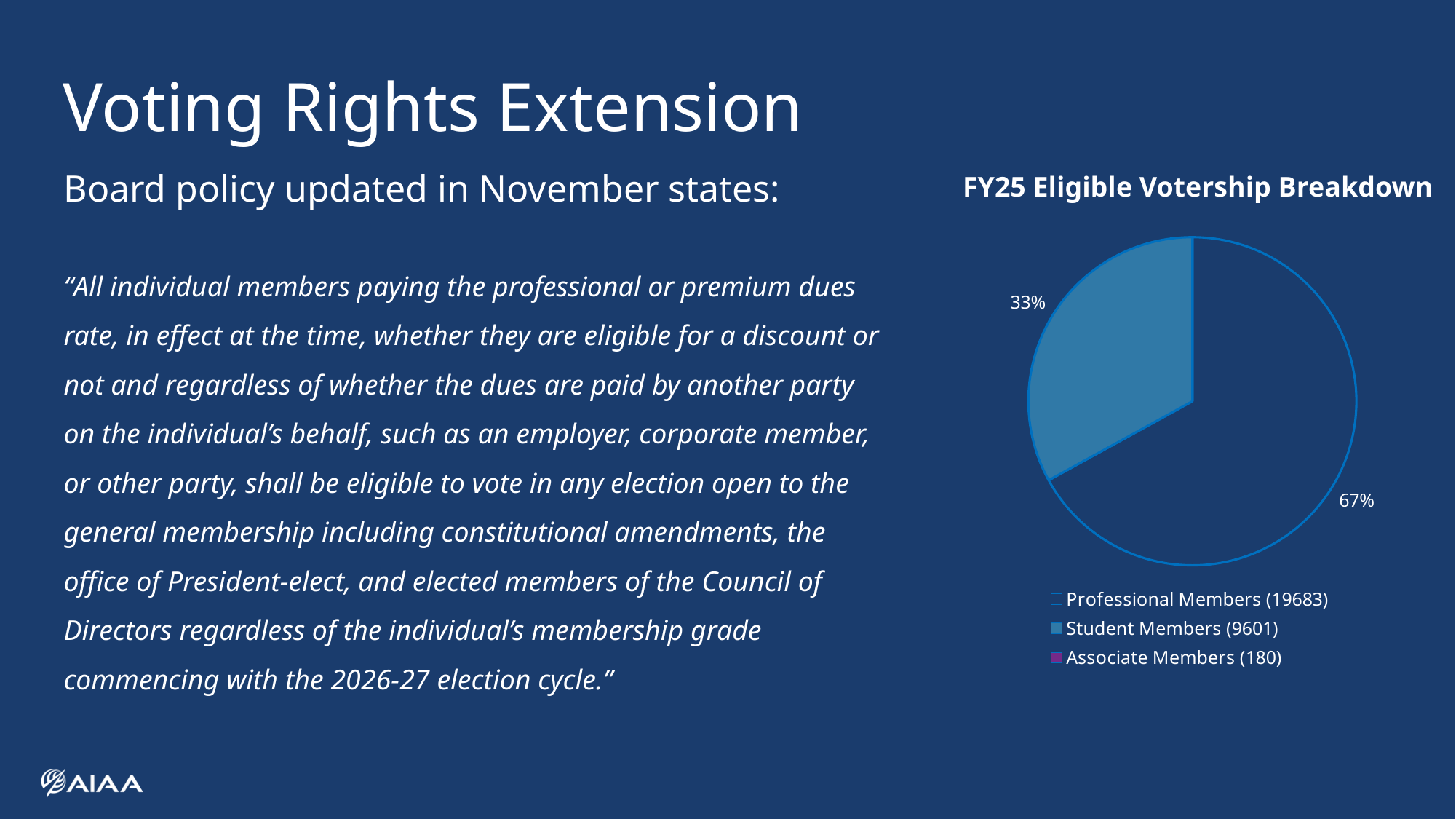
According to the legend, how many Professional Members are there? 19683 What share of the pie do Student Members represent? 33% According to the legend, how many Associate Members are there? 180 What is the difference in percentage points between the Professional Members share and the Student Members share? 34 What kind of chart is shown on the slide? pie chart What share of the pie do Professional Members represent? 67% What is the title of the chart on the slide? FY25 Eligible Votership Breakdown Which category has the smallest slice of the pie? Associate Members Which is larger, the Professional Members slice or the Student Members slice? Professional Members How many categories does the legend list? 3 According to the legend, how many Student Members are there? 9601 Which category has the largest slice of the pie? Professional Members